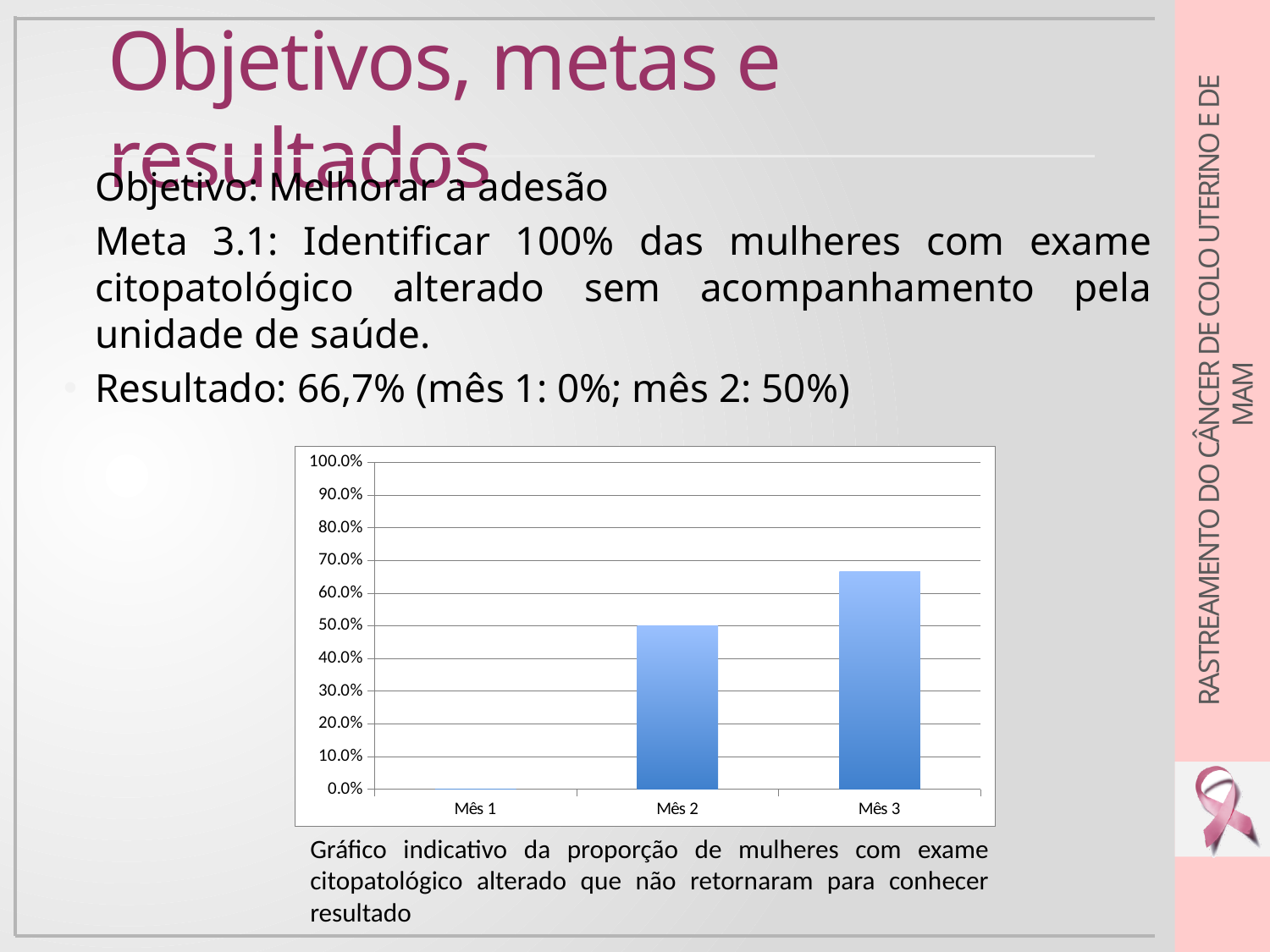
Do the values rise or fall from Mês 1 to Mês 3? rise How many categories (months) are plotted on the x axis of the chart? 3 Which month has the highest bar in the chart? Mês 3 What is the highest tick value shown on the y axis of the chart? 100.0% What is the value for Mês 2 in the chart? 50.0% What is the difference between the values for Mês 2 and Mês 1? 50.0% Which month has the lowest bar in the chart? Mês 1 What is the value for Mês 1 in the chart? 0.0% Which is larger, the value for Mês 3 or the value for Mês 2? Mês 3 Is the value for Mês 3 greater or less than 70.0%? less What kind of chart is shown on the slide? bar chart Is the value for Mês 3 greater or less than 60.0%? greater